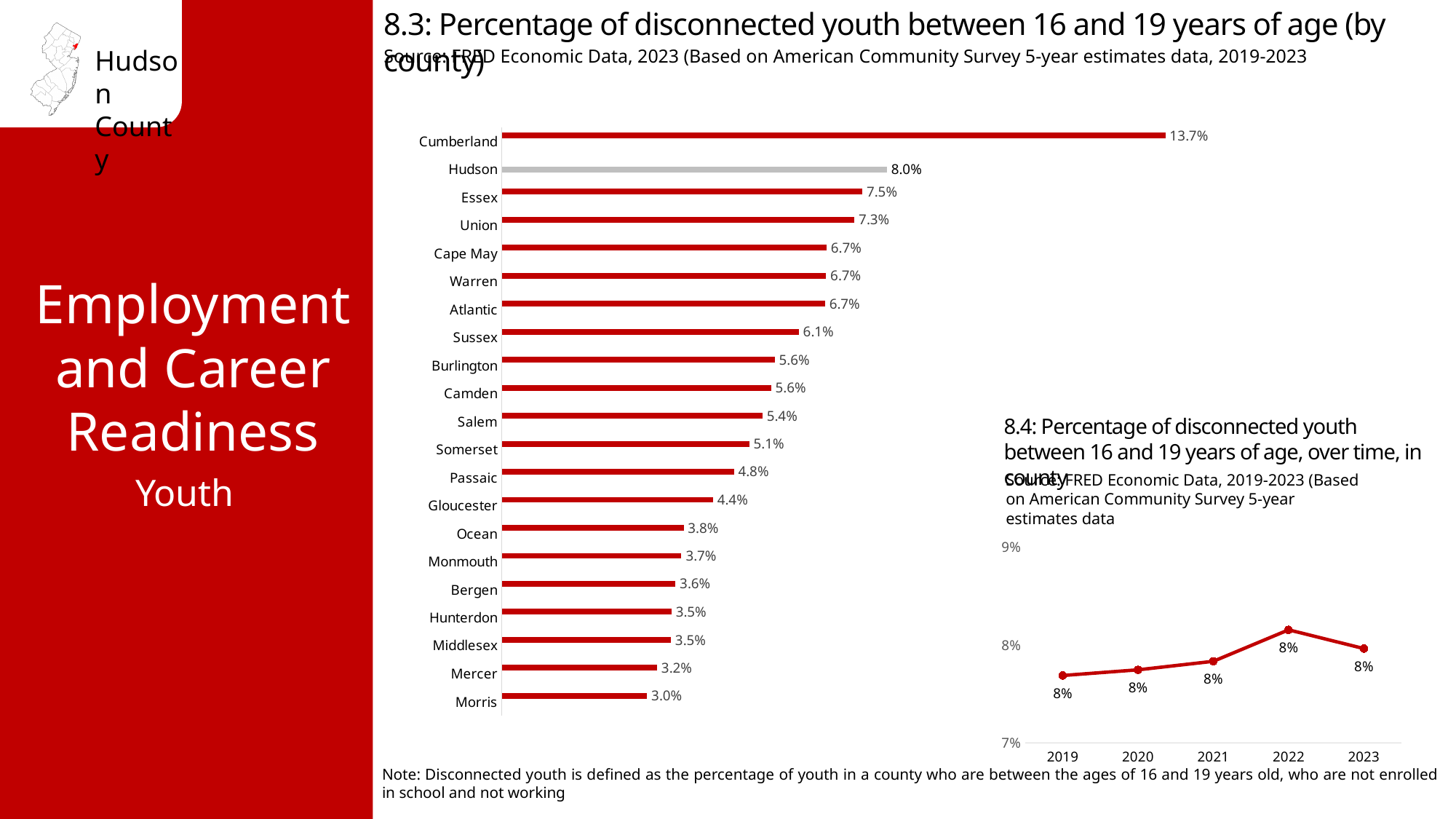
In the chart 8.3 (by county), which county has the lowest percentage of disconnected youth? Morris In the chart 8.3 (by county), which county has the highest percentage of disconnected youth? Cumberland In the chart 8.4 (over time), how many years are plotted? 5 In the chart 8.3 (by county), how many counties are shown? 21 In the chart 8.3 (by county), what is the difference between the values for Cumberland and Hudson? 5.7% In the chart 8.4 (over time), which year has the highest value? 2022 What kind of chart is chart 8.4 (over time)? Line chart In the chart 8.3 (by county), what is the value for Hudson? 8.0% In the chart 8.3 (by county), which has a higher value, Essex or Union? Essex What kind of chart is chart 8.3 (by county)? Bar chart In the chart 8.3 (by county), what is the value for Cumberland? 13.7% In the chart 8.3 (by county), what is the value for Mercer? 3.2%